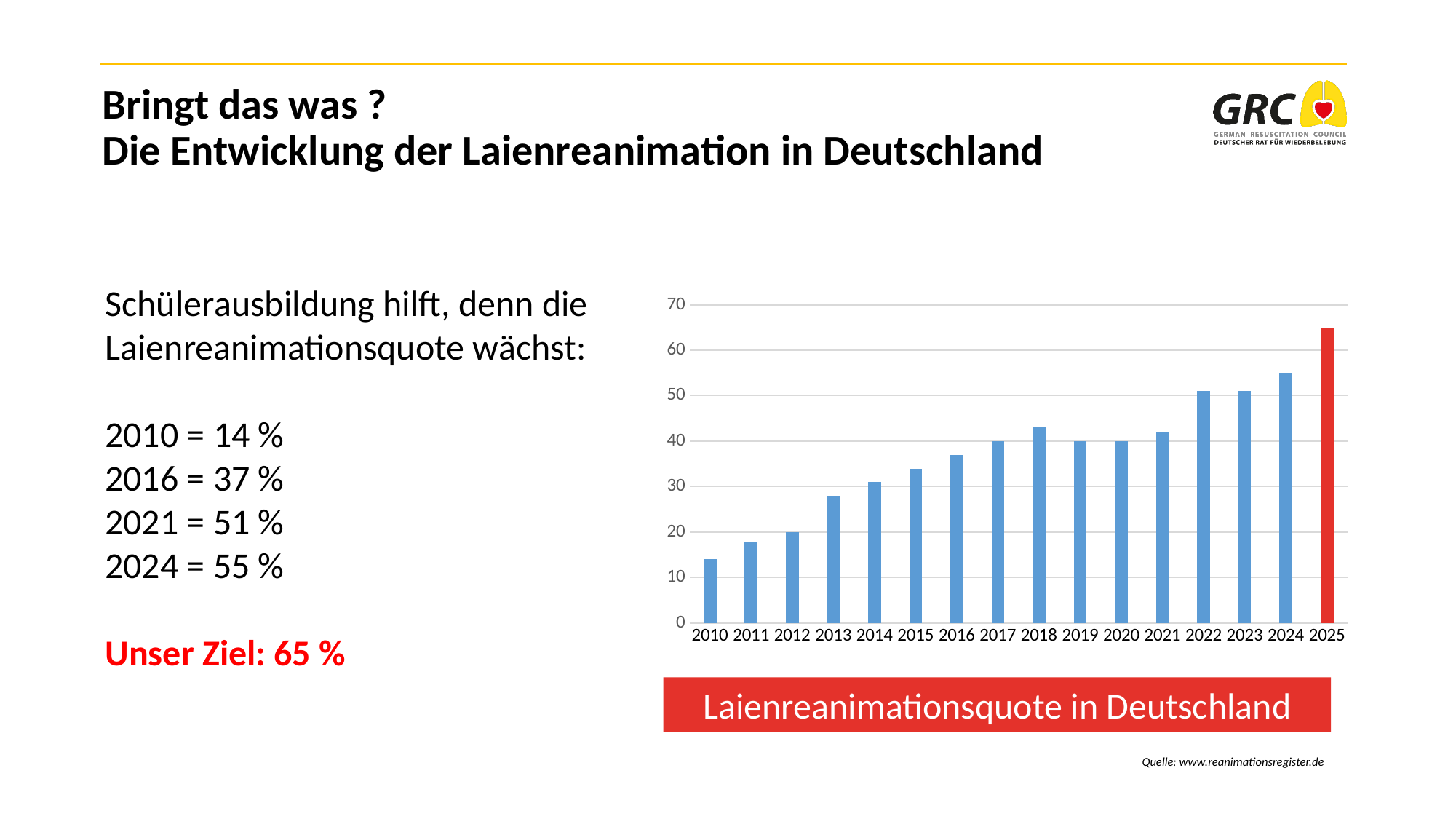
Which year has the highest bar in the chart? 2025 What is the Laienreanimationsquote for 2016? 37 % Do the values generally rise or fall from 2010 to 2025? rise What value does the red bar for 2025 represent? 65 % Which year has the lowest bar in the chart? 2010 Which is larger, the value for 2018 or the value for 2015? 2018 What kind of chart is shown on the slide? bar chart What is the Laienreanimationsquote for 2010? 14 % What is the Laienreanimationsquote for 2024? 55 % What is the difference between the values for 2024 and 2010? 41 % How many years are shown on the x axis of the chart? 16 Is the value for 2013 greater or less than 30? less